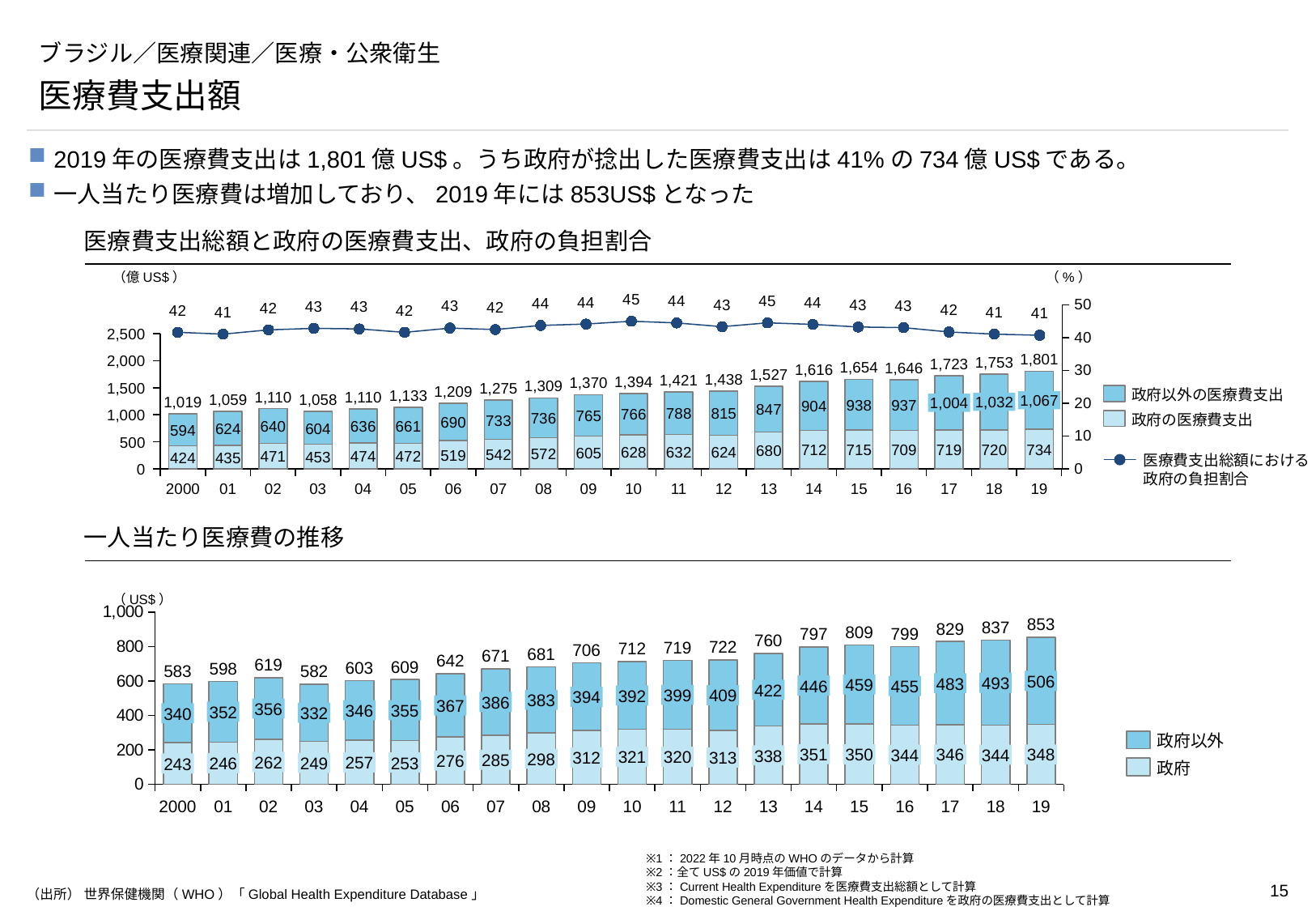
In the bottom chart (一人当たり医療費の推移), what is the total per-capita medical expenditure for 2019? 853 In the bottom chart, how many years are shown on the x axis? 20 In the top chart, what is the 政府の負担割合 (%) value for 2010? 45 In the top chart (医療費支出総額と政府の医療費支出、政府の負担割合), what is the value of 政府の医療費支出 for 2019? 734 In the top chart, how many entries does the legend list? 3 In the bottom chart, is the 政府以外 value larger in 2016 or in 2017? 2017 In the bottom chart, which year has the lowest total per-capita medical expenditure? 03 In the top chart, what is the total medical expenditure shown above the bar for 2013? 1,527 What kind of chart is the bottom chart (一人当たり医療費の推移)? Stacked bar chart In the top chart, what is the difference between 政府以外の医療費支出 and 政府の医療費支出 in 2019? 333 In the top chart, which year has the highest total medical expenditure? 19 In the bottom chart, what is the 政府 value for 2008? 298